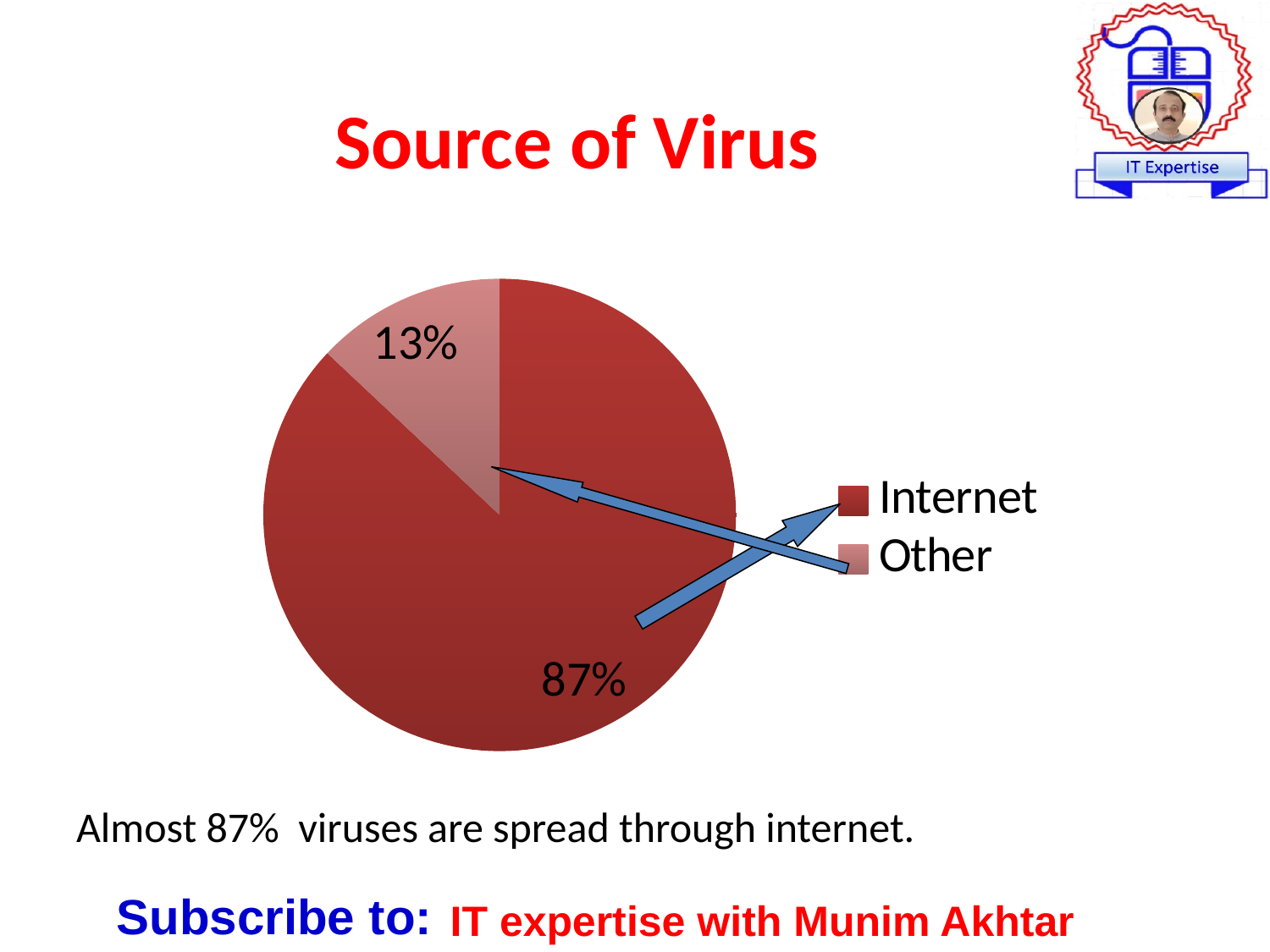
What kind of chart is shown on the slide? pie chart How many slices does the pie chart have? 2 Which legend entry is shown in the lighter pink colour? Other What is the difference in percentage points between the Internet and Other slices? 74 Which category has the smallest slice of the pie? Other Which category has the largest slice of the pie? Internet What is the title shown above the chart? Source of Virus What share of the pie does Internet account for? 87% Which slice is larger, Internet or Other? Internet What share of the pie does Other account for? 13% How many entries does the legend list? 2